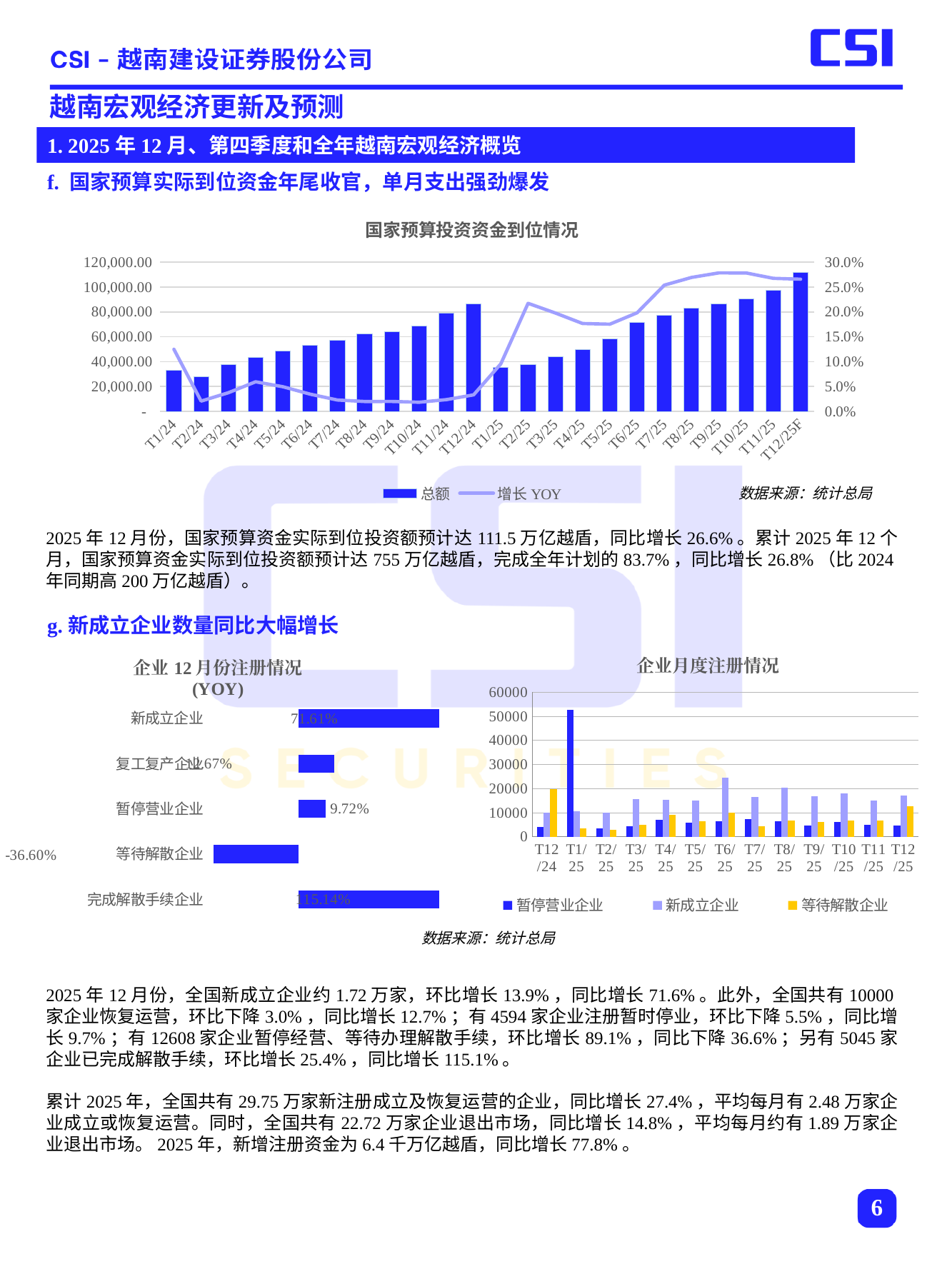
In the '国家预算投资资金到位情况' chart, which period has the highest 总额 bar? T12/25F In the '国家预算投资资金到位情况' chart, is the 总额 value for T12/25F greater or less than 100,000.00? greater In the '国家预算投资资金到位情况' chart, how many series does the legend list? 2 In the '国家预算投资资金到位情况' chart, how many periods are shown on the x axis? 24 In the '企业月度注册情况' chart, how many series does the legend list? 3 What kind of chart is the '国家预算投资资金到位情况' chart? A combined bar and line chart In the '企业 12 月份注册情况 (YOY)' chart, which category has the highest value? 完成解散手续企业 In the '企业 12 月份注册情况 (YOY)' chart, what is the value for 等待解散企业? -36.60% In the '国家预算投资资金到位情况' chart, do the 总额 bars rise or fall from T1/24 to T12/24? rise In the '国家预算投资资金到位情况' chart, which period has the lowest 总额 bar? T2/24 In the '企业 12 月份注册情况 (YOY)' chart, what is the value for 新成立企业? 71.61% In the '企业月度注册情况' chart, is the 暂停营业企业 value for T1/25 greater or less than 40000? greater